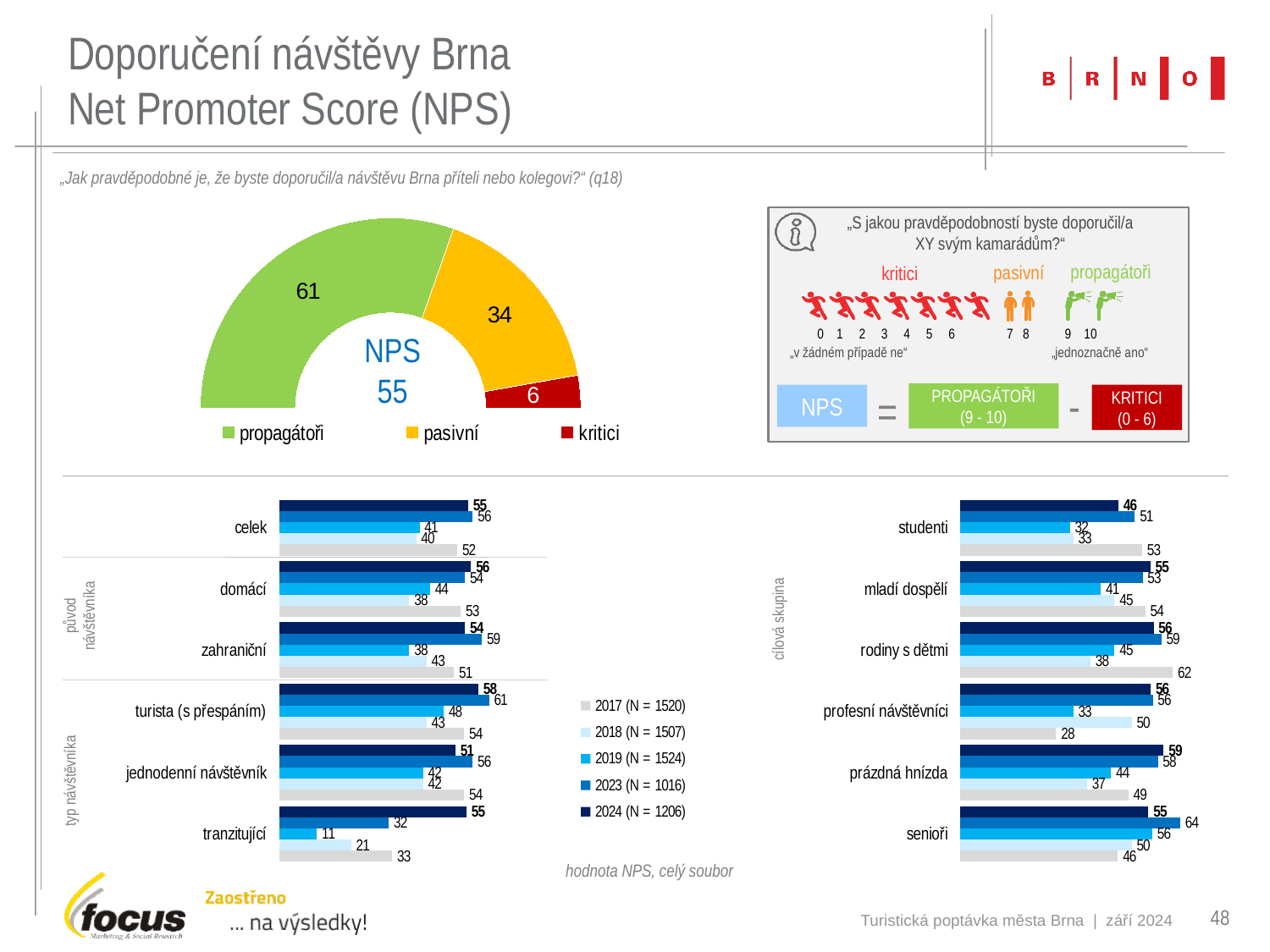
How many series does the legend of the bar charts list? 5 In the semicircle chart at the top, which segment is the smallest? kritici What NPS value is printed in the centre of the semicircle chart at the top? 55 In the bar chart on the left (původ / typ návštěvníka), which is larger for turista (s přespáním): the 2023 value or the 2024 value? 2023 value (61) In the bar chart on the left (původ / typ návštěvníka), what is the 2019 value for tranzitující? 11 In the bar chart on the right (cílová skupina), what is the 2023 value for senioři? 64 In the semicircle chart at the top, what is the difference between propagátoři and pasivní? 27 In the bar chart on the right (cílová skupina), what is the difference between the 2017 and 2018 values for profesní návštěvníci? 22 What sample size (N) does the legend give for 2024? 1206 In the bar chart on the left (původ / typ návštěvníka), what is the 2024 value for tranzitující? 55 How many categories does the bar chart on the right (cílová skupina) show? 6 In the semicircle chart at the top, what is the value for propagátoři? 61